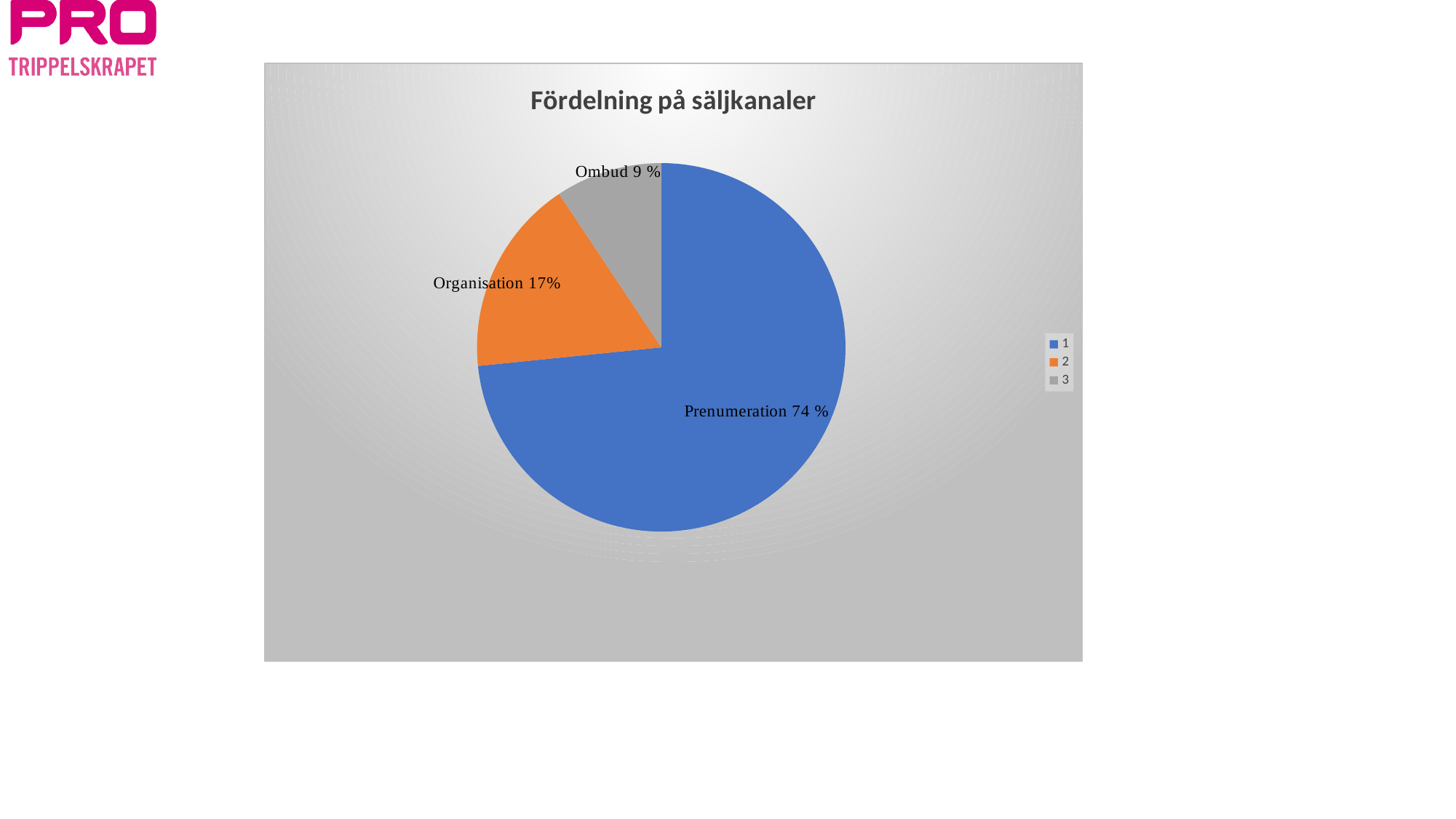
What share of the pie does Ombud have? 9 % Which slice of the pie is the largest? Prenumeration What share of the pie does Organisation have? 17% What is the difference in percentage points between the Prenumeration share and the Organisation share? 57 What is the title of the chart? Fördelning på säljkanaler What kind of chart is shown on the slide? pie chart How many entries does the legend list? 3 How many slices does the pie chart have? 3 What colour is the Prenumeration slice? blue What share of the pie does Prenumeration have? 74 % Which slice of the pie is the smallest? Ombud Which is larger, the Organisation slice or the Ombud slice? Organisation